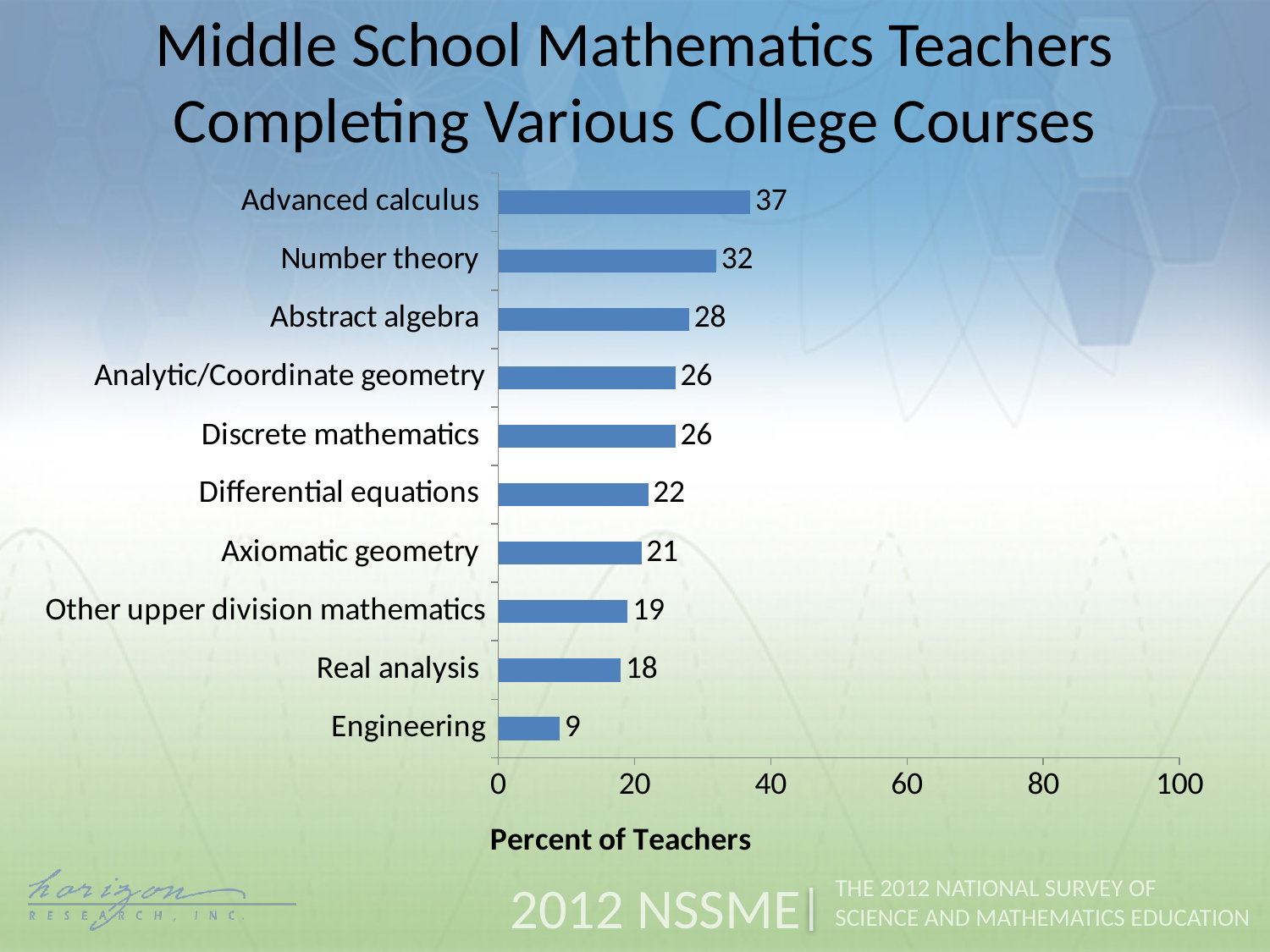
What kind of chart is shown on the slide? bar chart Which course has the lowest percent of teachers completing it? Engineering What is the difference between the values for Advanced calculus and Number theory? 5 What is the difference between the values for Abstract algebra and Engineering? 19 What percent of middle school mathematics teachers completed Advanced calculus? 37 How many courses are shown in the chart? 10 What is the label of the horizontal axis? Percent of Teachers Is the value for Number theory greater or less than 40? less Which is larger, the value for Axiomatic geometry or the value for Other upper division mathematics? Axiomatic geometry What is the value shown for Real analysis? 18 What is the value shown for Differential equations? 22 Which course has the highest percent of teachers completing it? Advanced calculus